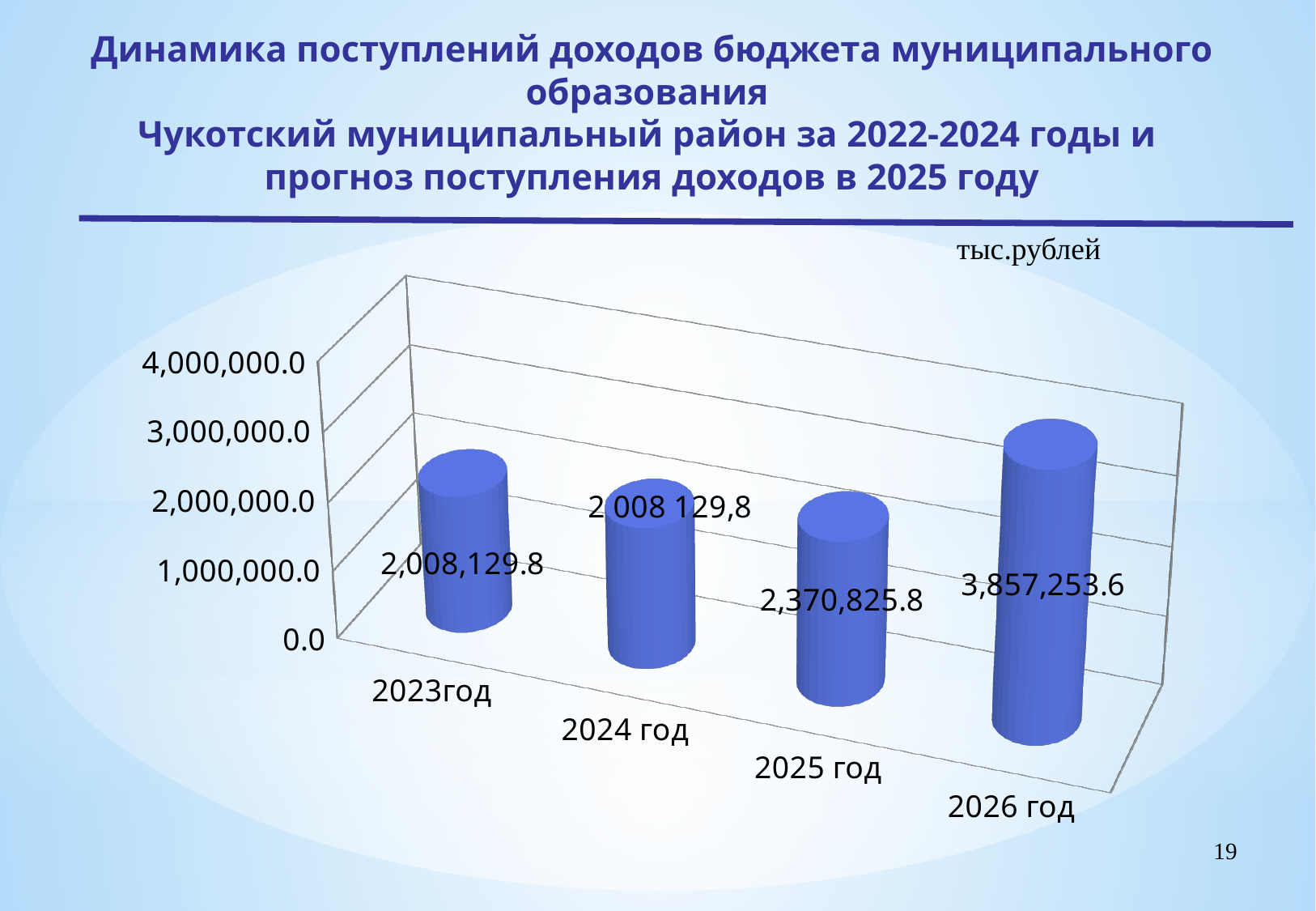
What is the value for 2026 год? 3,857,253.6 What is the value for 2025 год? 2,370,825.8 What is the difference between the values for 2025 год and 2023 год? 362,696.0 What is the value for 2023 год? 2,008,129.8 What unit of measurement is indicated above the chart? тыс.рублей Which is larger, the value for 2025 год or the value for 2026 год? 2026 год What kind of chart is shown on the slide? bar chart Is the value for 2026 год greater or less than 3,000,000.0? greater How many years are shown on the chart? 4 What is the value labelled on the bar for 2024 год? 2 008 129,8 Which year has the highest value? 2026 год What is the difference between the values for 2026 год and 2025 год? 1,486,427.8